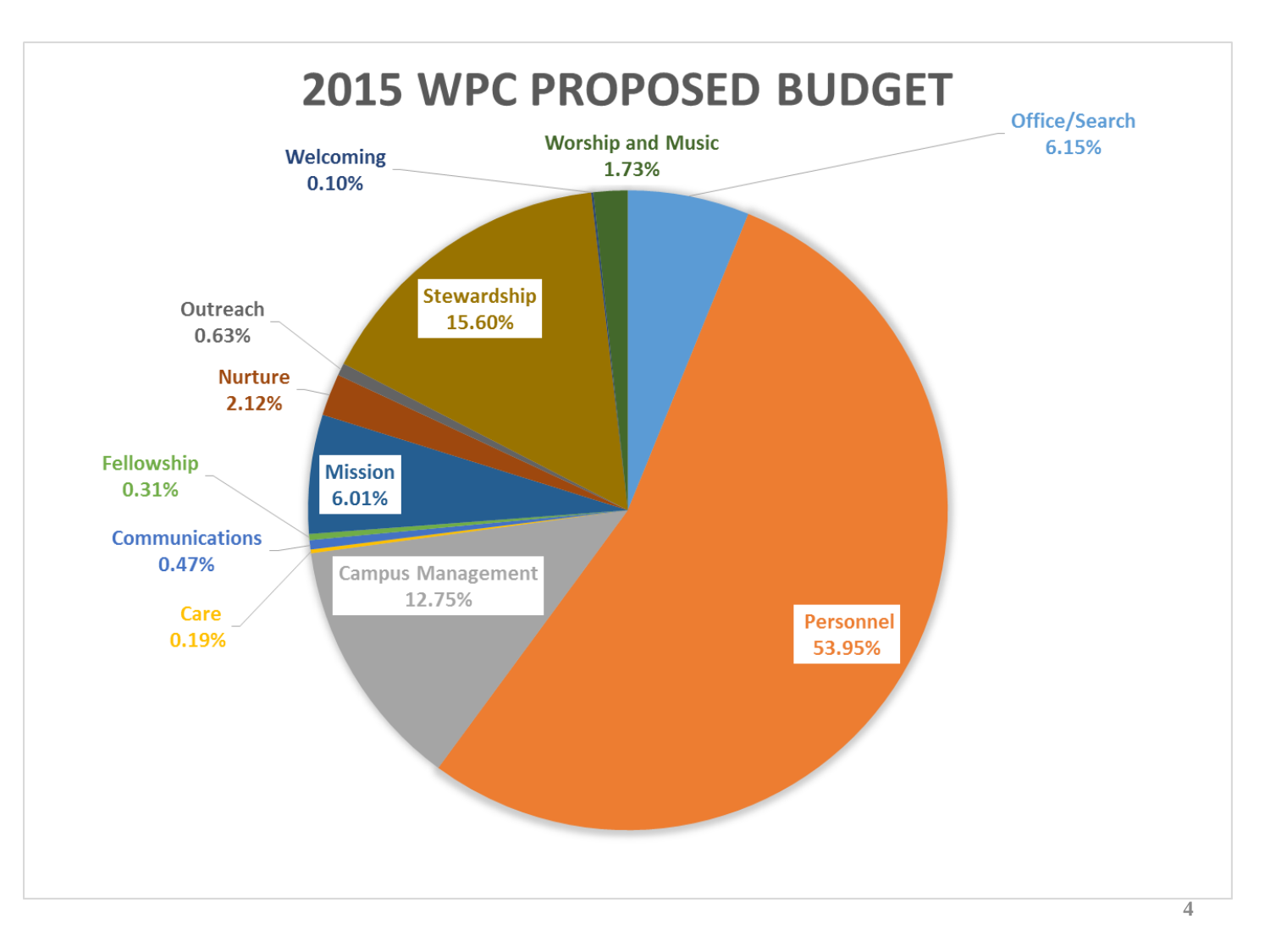
Which has a larger share of the budget, Office/Search or Mission? Office/Search What is the difference between the Stewardship and Campus Management shares? 2.85% What percentage of the budget is allocated to Stewardship? 15.60% What type of chart is shown on the slide? Pie chart What is the combined share of Nurture and Outreach? 2.75% What is the title of the chart? 2015 WPC PROPOSED BUDGET What percentage of the budget is allocated to Welcoming? 0.10% Which category has the smallest share of the budget? Welcoming Which category has the largest share of the budget? Personnel What percentage of the budget is allocated to Personnel? 53.95% How many categories are shown in the pie chart? 12 What percentage of the budget is allocated to Campus Management? 12.75%